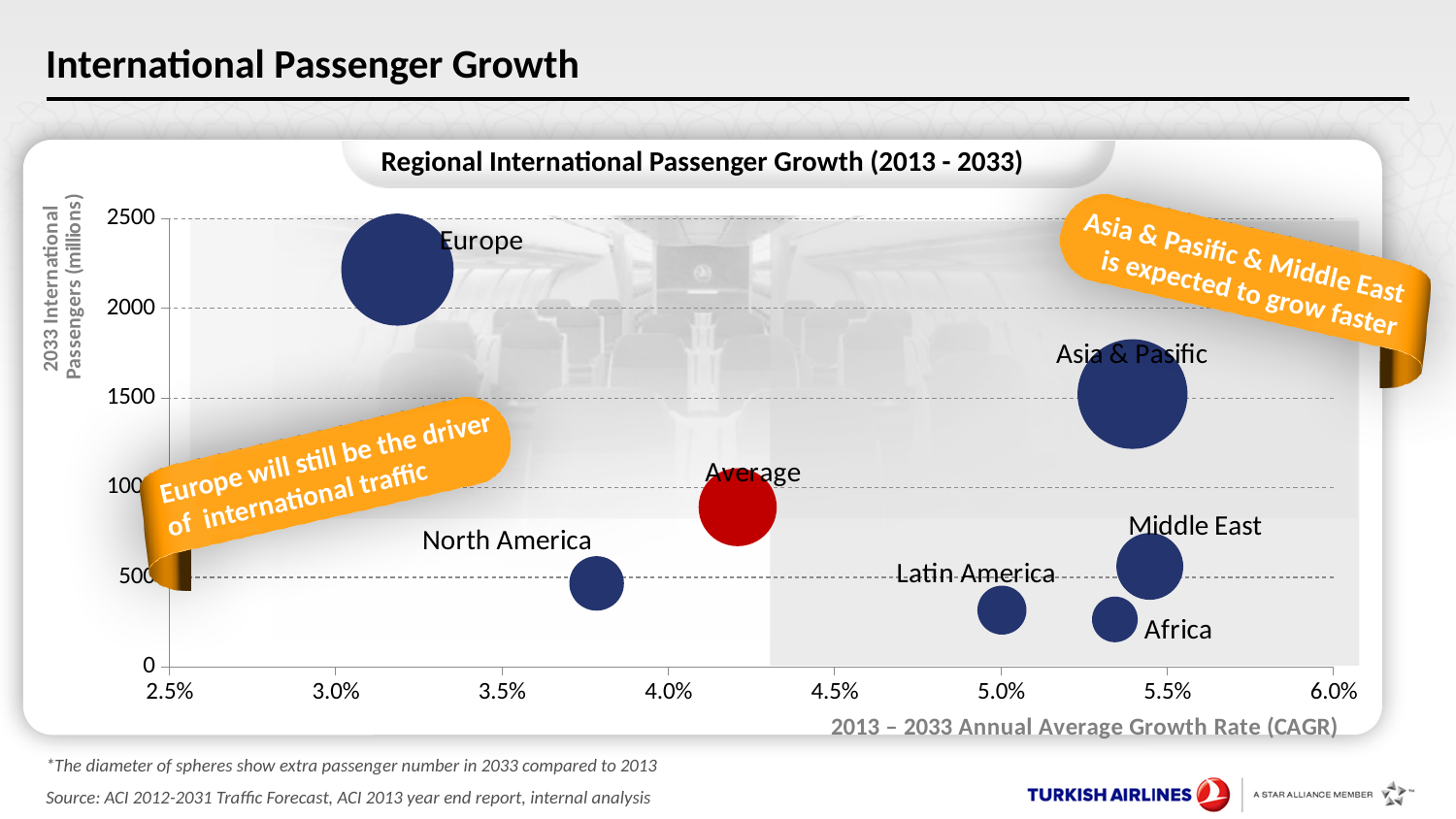
Is the 2033 international passengers value for Africa greater or less than 500? less Which region has the highest 2033 international passengers value? Europe What type of chart is shown on the slide? Bubble chart How many bubbles (regions including Average) are plotted on the chart? 7 What is the label of the horizontal axis? 2013 – 2033 Annual Average Growth Rate (CAGR) Is the 2033 international passengers value for Asia & Pasific greater or less than 1000? greater Is the 2033 international passengers value for Latin America greater or less than 500? less What is the title of the chart? Regional International Passenger Growth (2013 - 2033) Which has a higher 2033 international passengers value, Europe or Asia & Pasific? Europe